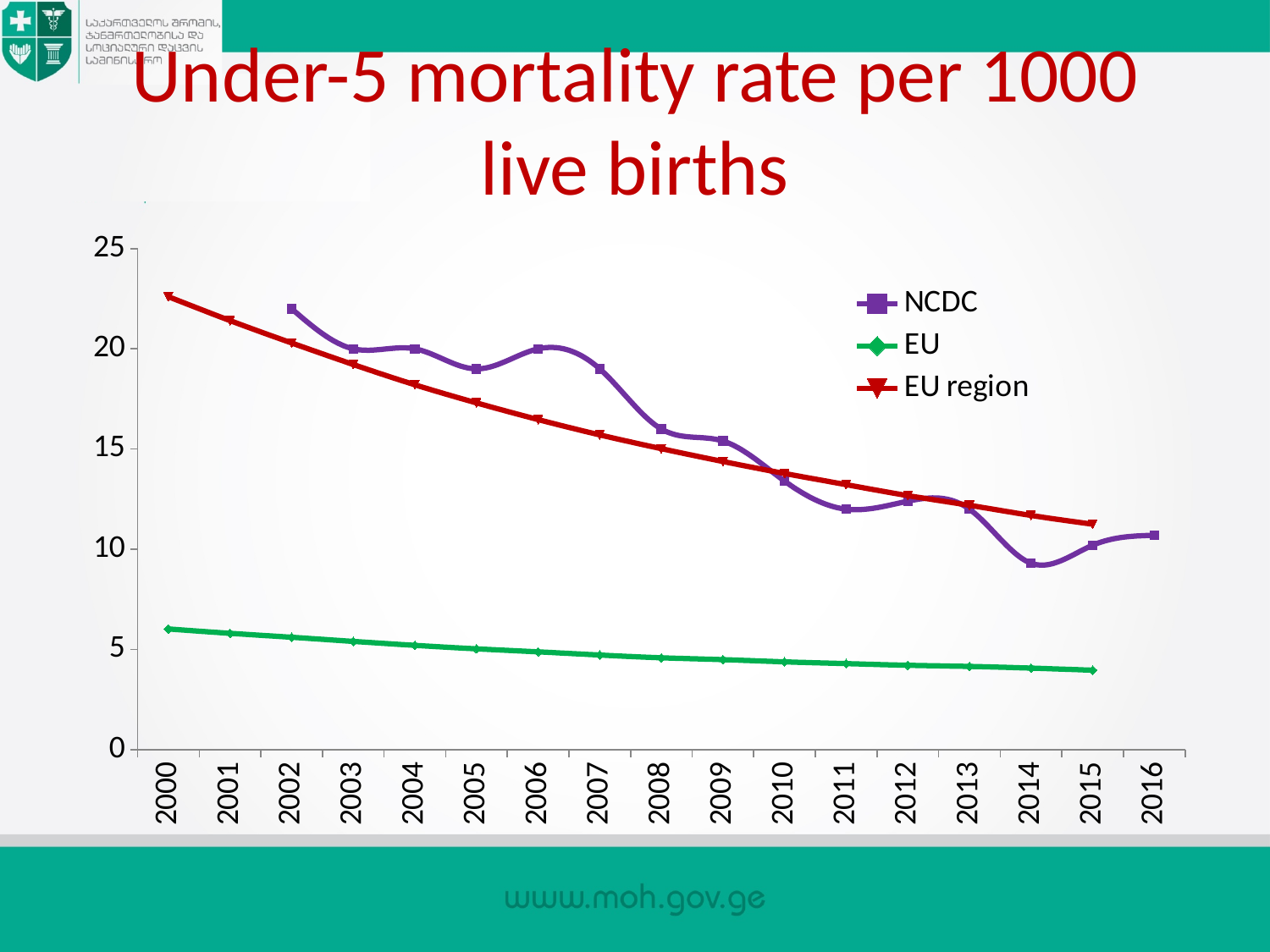
Does the EU region series rise or fall from 2000 to 2015? fall In 2014, which is larger: the NCDC value or the EU region value? EU region Is the NCDC value for 2002 greater or less than 20? greater Is the EU region value for 2000 greater or less than 20? greater How many series does the legend list? 3 Does the EU series rise or fall from 2000 to 2015? fall What is the title of the chart? Under-5 mortality rate per 1000 live births How many years are shown on the x axis? 17 What kind of chart is shown on the slide? line chart Is the EU value for 2015 greater or less than 5? less Which series has the lowest values across all years? EU